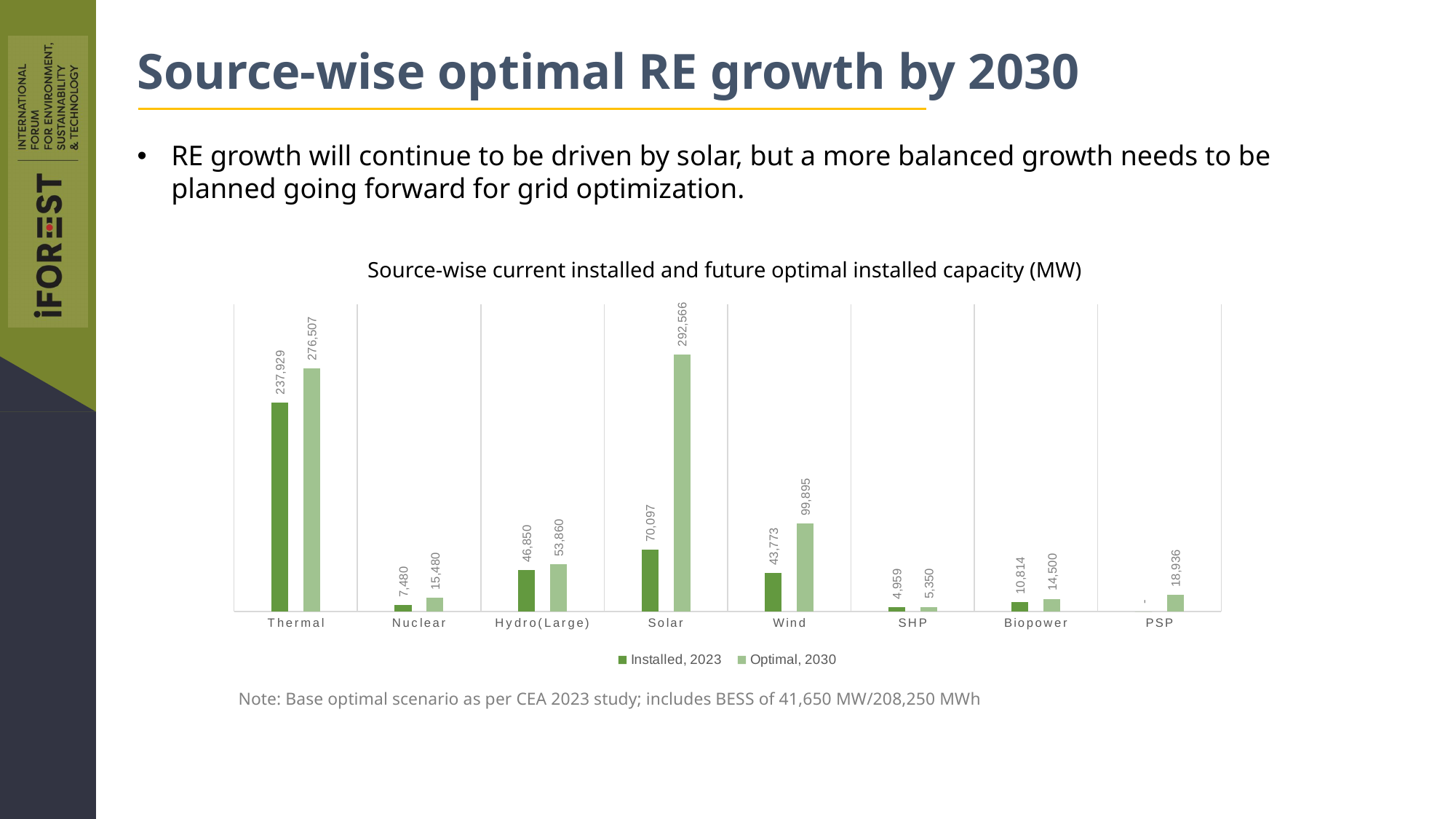
Which category has the lowest Installed, 2023 value among those with a printed label? SHP How many series does the legend list? 2 What is the Optimal, 2030 value for Solar? 292,566 What kind of chart is shown on the slide? Bar chart Which category has the highest Optimal, 2030 value? Solar Which is larger: the Optimal, 2030 value for Thermal or the Optimal, 2030 value for Solar? Solar What is the difference between the Optimal, 2030 and Installed, 2023 values for Solar? 222,469 What is the Optimal, 2030 value for Wind? 99,895 What is the Installed, 2023 value for Nuclear? 7,480 What is the Installed, 2023 value for Thermal? 237,929 What is the title of the chart? Source-wise current installed and future optimal installed capacity (MW) How many categories are shown on the x axis? 8